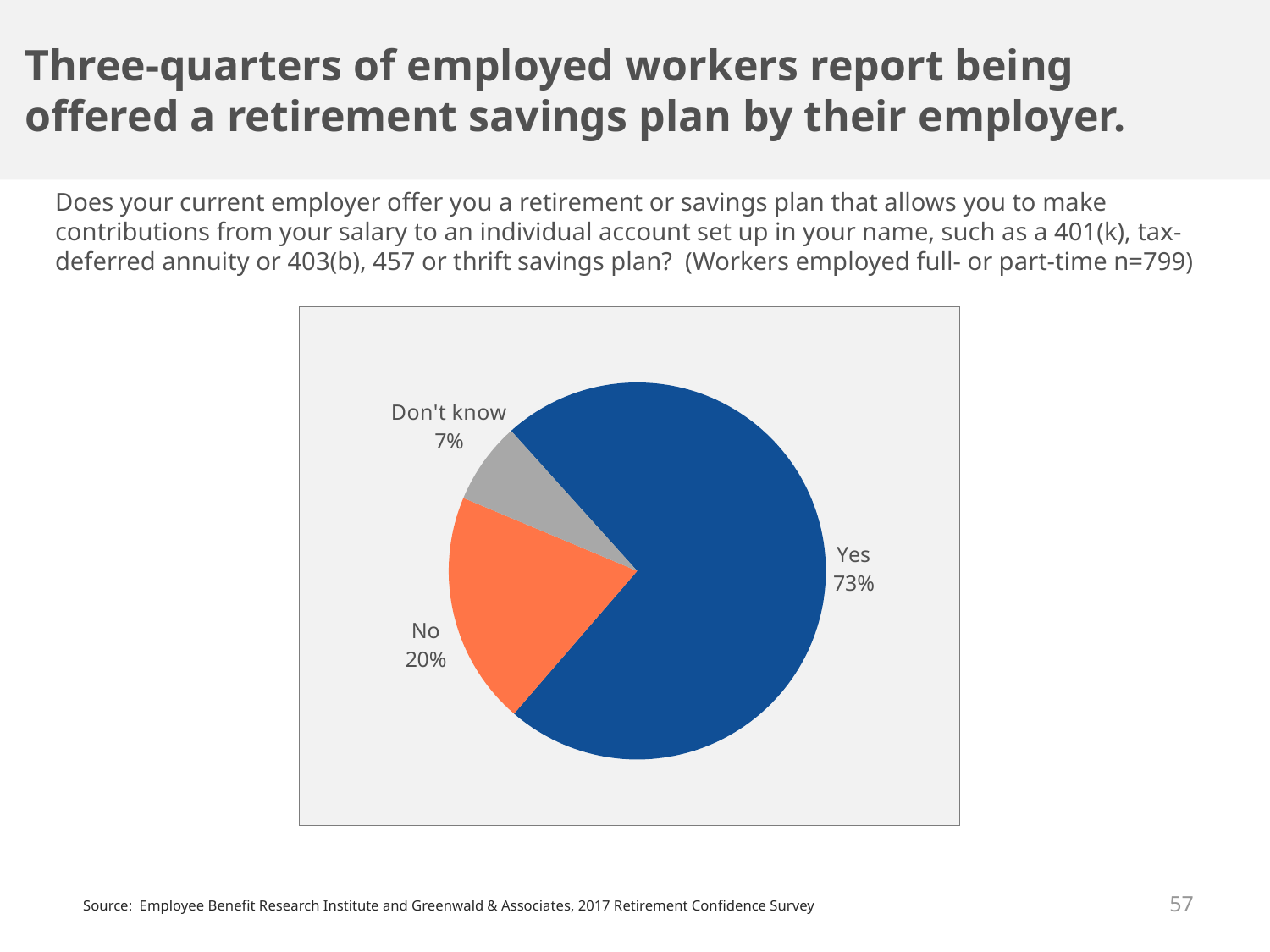
What is the difference in percentage points between "Yes" and "No"? 53 What colour is the "Yes" slice? blue Which response has the smallest share of the pie? Don't know Which response has the largest share of the pie? Yes What percentage of workers answered "Yes"? 73% What percentage of workers answered "No"? 20% What is the difference in percentage points between "No" and "Don't know"? 13 What percentage of workers answered "Don't know"? 7% Which is larger, the share for "No" or the share for "Don't know"? No What kind of chart is shown on the slide? pie chart How many slices does the pie chart have? 3 What colour is the "No" slice? orange